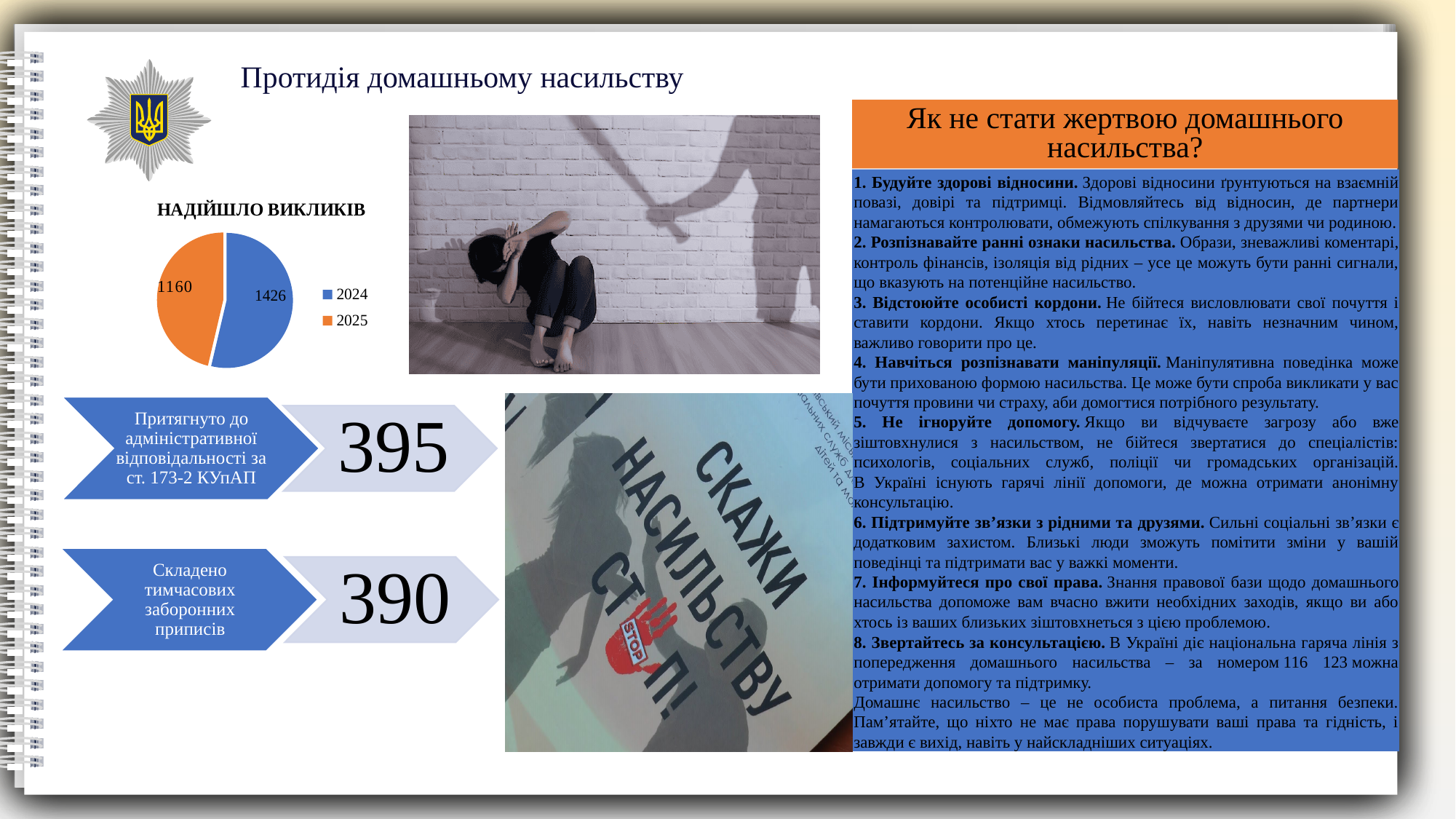
Which year has the larger slice in the "НАДІЙШЛО ВИКЛИКІВ" pie chart? 2024 What is the value for 2025 in the "НАДІЙШЛО ВИКЛИКІВ" pie chart? 1160 In the "НАДІЙШЛО ВИКЛИКІВ" pie chart, is the value for 2024 larger or smaller than the value for 2025? Larger What is the title of the pie chart on the slide? НАДІЙШЛО ВИКЛИКІВ How many slices does the "НАДІЙШЛО ВИКЛИКІВ" pie chart have? 2 What type of chart is shown under the title "НАДІЙШЛО ВИКЛИКІВ"? Pie chart How many entries does the legend of the "НАДІЙШЛО ВИКЛИКІВ" pie chart list? 2 What is the total of the two slices in the "НАДІЙШЛО ВИКЛИКІВ" pie chart? 2586 What is the value for 2024 in the "НАДІЙШЛО ВИКЛИКІВ" pie chart? 1426 In the "НАДІЙШЛО ВИКЛИКІВ" pie chart, what is the difference between the 2024 and 2025 values? 266 Which year has the smaller slice in the "НАДІЙШЛО ВИКЛИКІВ" pie chart? 2025 What colour is the 2025 slice in the "НАДІЙШЛО ВИКЛИКІВ" pie chart? Orange